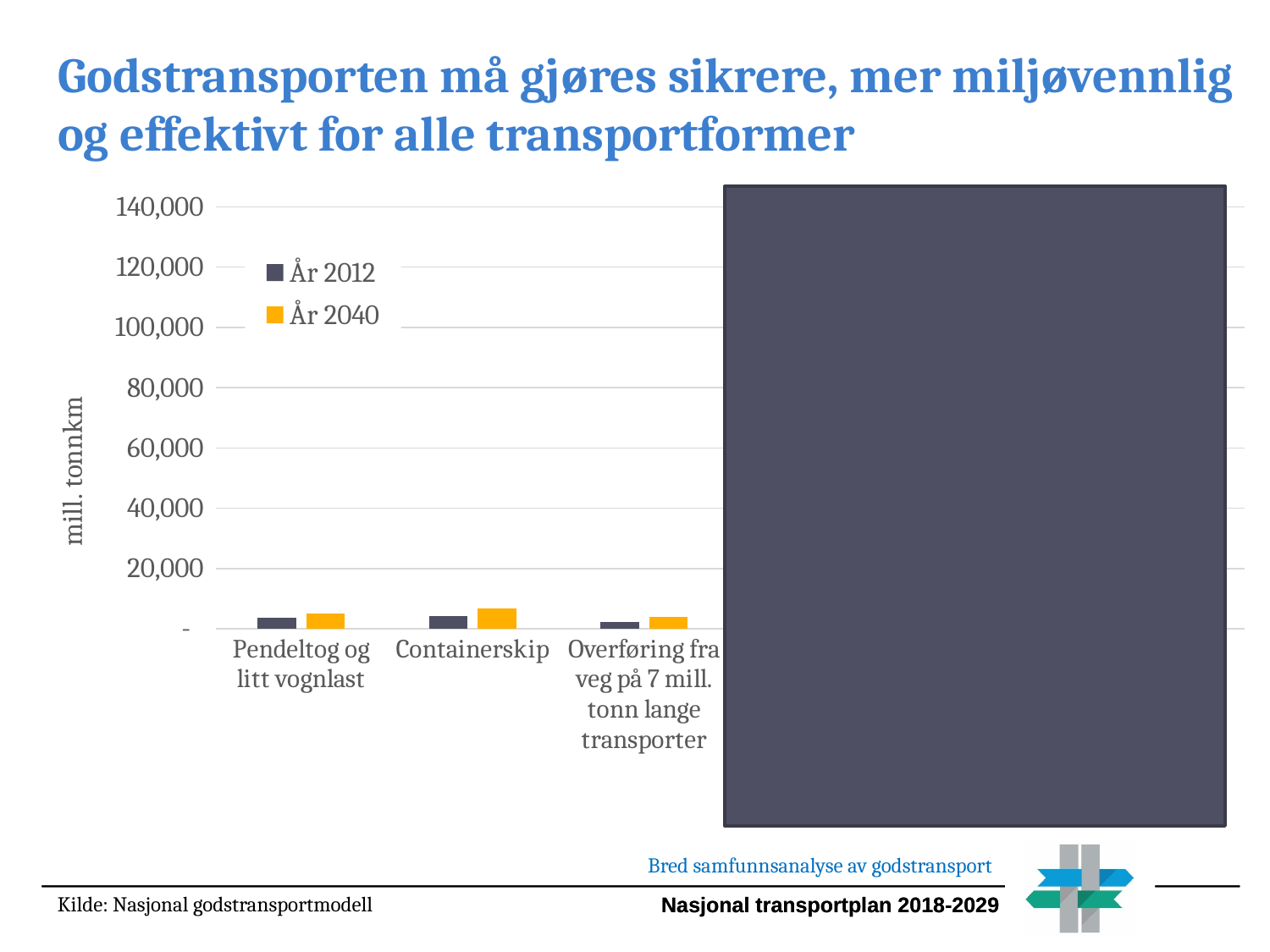
What kind of chart is shown on the slide? bar chart Is the År 2040 value for Overføring fra veg på 7 mill. tonn lange transporter greater or less than 20,000? less Is the År 2040 value for Containerskip greater or less than 20,000? less For Overføring fra veg på 7 mill. tonn lange transporter, which series has the larger value, År 2012 or År 2040? År 2040 How many series does the chart legend list? 2 Among the visible categories, which has the highest År 2040 value? Containerskip For Pendeltog og litt vognlast, which series has the larger value, År 2012 or År 2040? År 2040 For Containerskip, which series has the larger value, År 2012 or År 2040? År 2040 Is the År 2012 value for Pendeltog og litt vognlast greater or less than 20,000? less What are the two series named in the chart legend? År 2012 and År 2040 What is the label on the vertical axis of the chart? mill. tonnkm Among the visible categories, which has the lowest År 2012 value? Overføring fra veg på 7 mill. tonn lange transporter